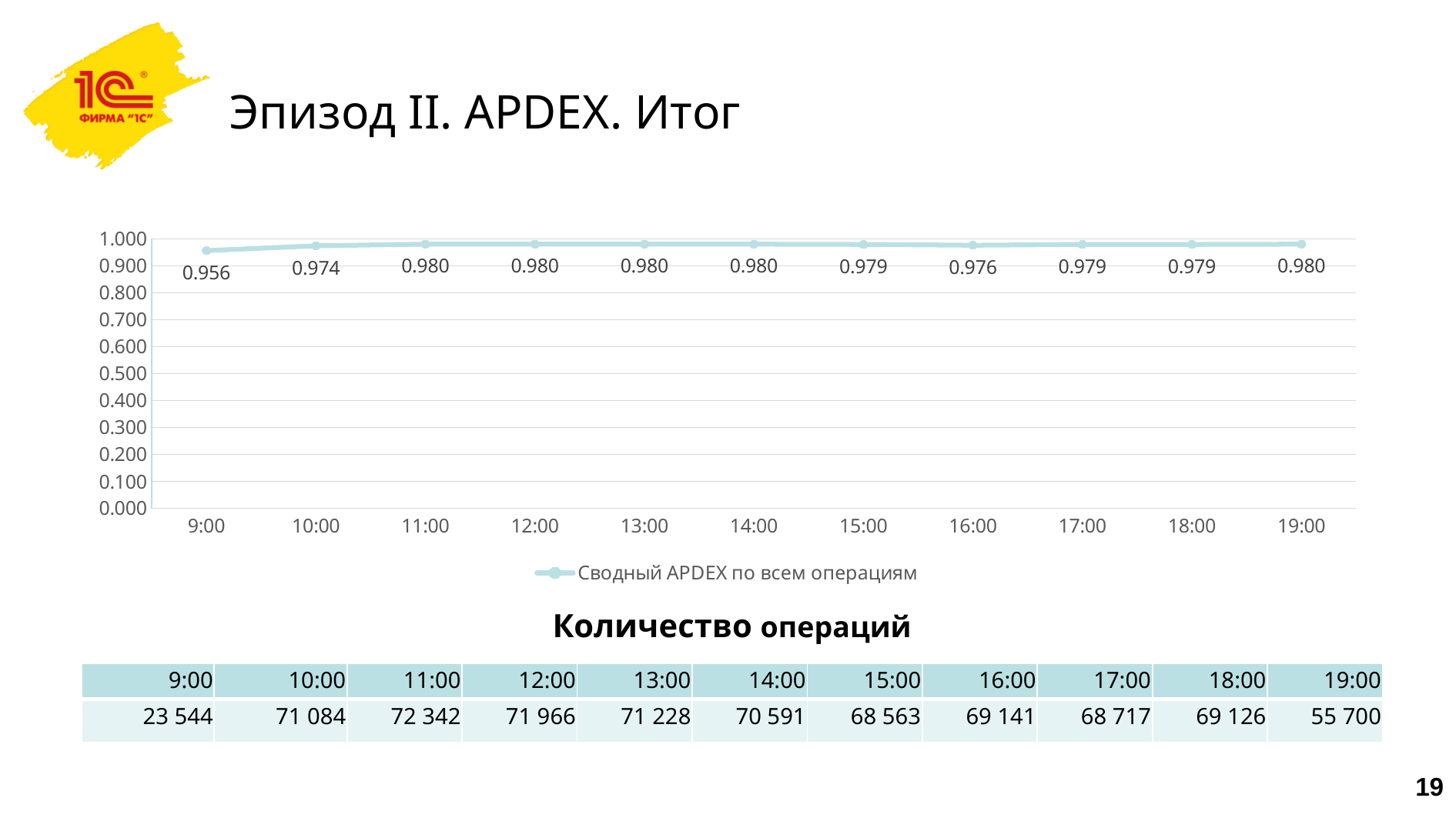
What is the value of the line at 9:00? 0.956 Does the plotted value rise or fall from 9:00 to 11:00? rise How many time points are plotted on the chart? 11 What is the value of the line at 16:00? 0.976 How many series does the legend list? 1 Which is larger, the value at 10:00 or the value at 16:00? 16:00 At which time is the plotted value lowest? 9:00 What is the value of the line at 10:00? 0.974 Is the value at 9:00 greater or less than 0.900? greater What kind of chart is shown on the slide? line chart What is the name of the series shown in the legend? Сводный APDEX по всем операциям What is the difference between the values at 11:00 and 9:00? 0.024